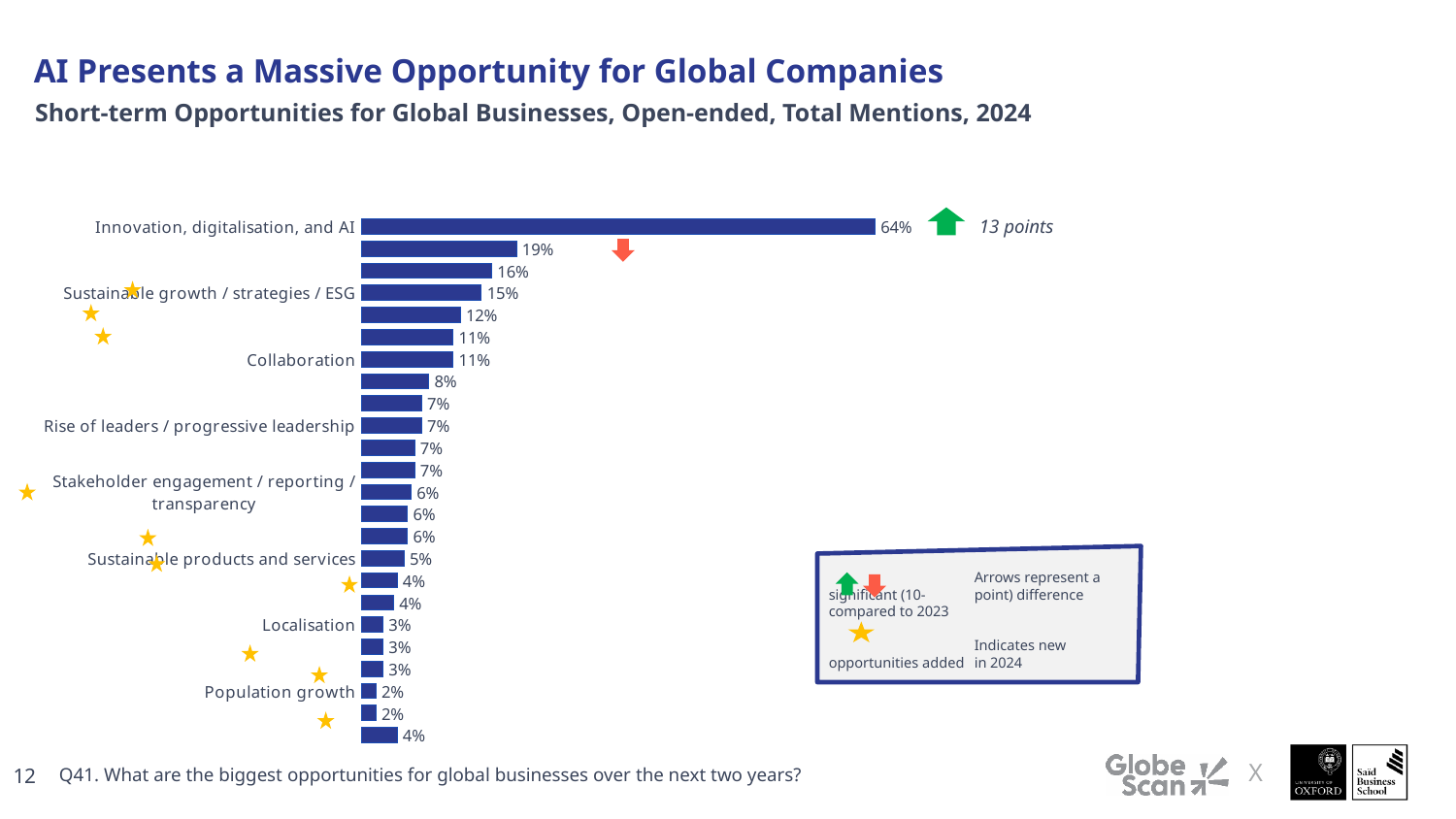
How many bars are plotted in the chart? 24 What is the difference between the values for Innovation, digitalisation, and AI and Sustainable growth / strategies / ESG? 49 percentage points What is the value for Innovation, digitalisation, and AI? 64% Which is larger, the value for Collaboration or the value for Localisation? Collaboration What is the value for Collaboration? 11% What is the value for Sustainable growth / strategies / ESG? 15% What is the value for Localisation? 3% What kind of chart is shown on the slide? Bar chart Which category has the highest value? Innovation, digitalisation, and AI What is the value for Population growth? 2% What is the value for Rise of leaders / progressive leadership? 7% What is the value for Sustainable products and services? 5%